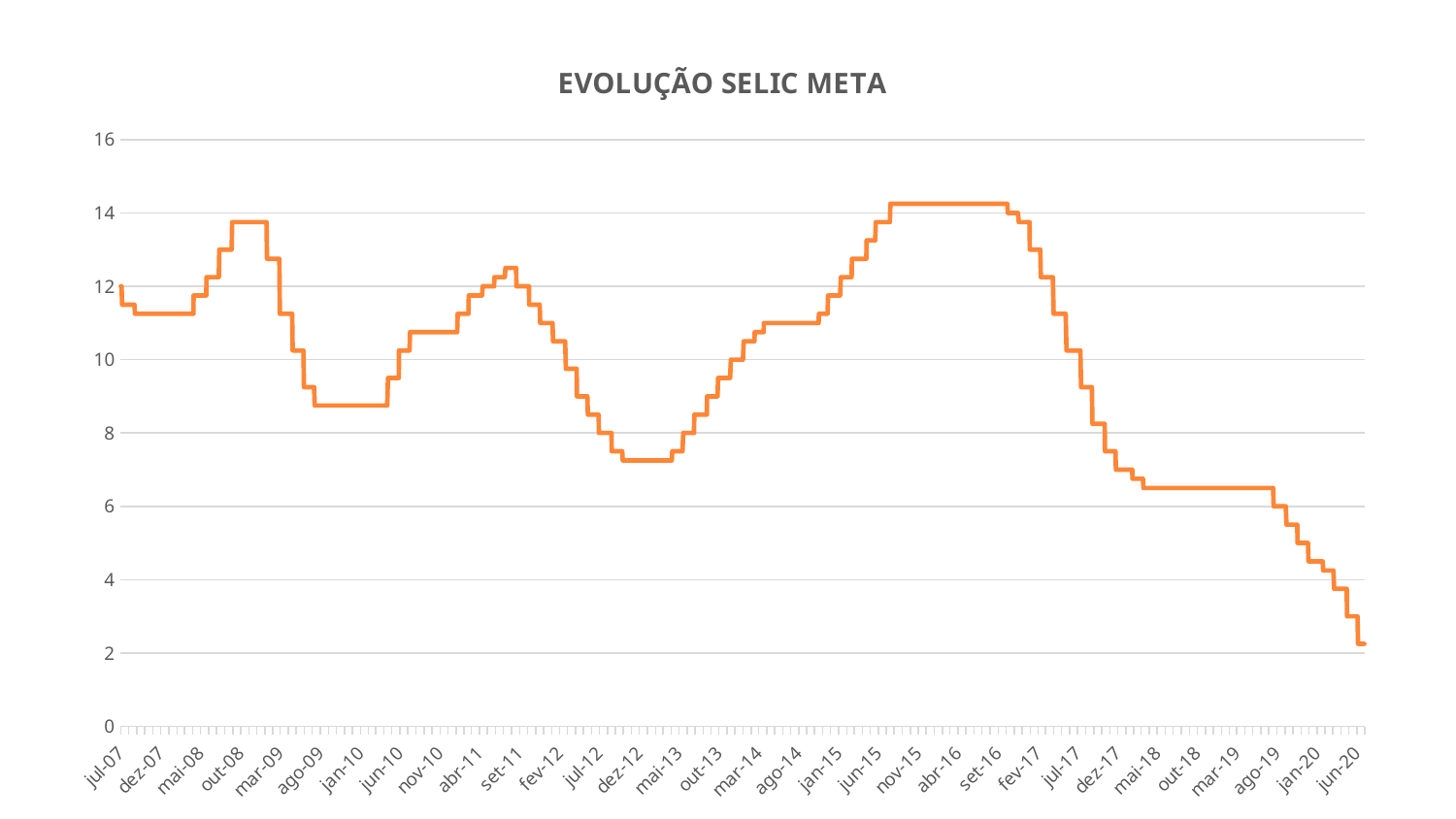
At which x-axis label does the line reach its lowest value? jun-20 Is the value for jan-10 greater or less than 10? less Which is larger, the value at out-08 or the value at jan-10? out-08 Is the value for mar-18 greater or less than 8? less Is the value for dez-12 greater or less than 8? less What kind of chart is shown on the slide? Line chart What colour is the line in the chart? Orange Does the line rise or fall between set-16 and jun-20? Fall What is the title of the chart? EVOLUÇÃO SELIC META